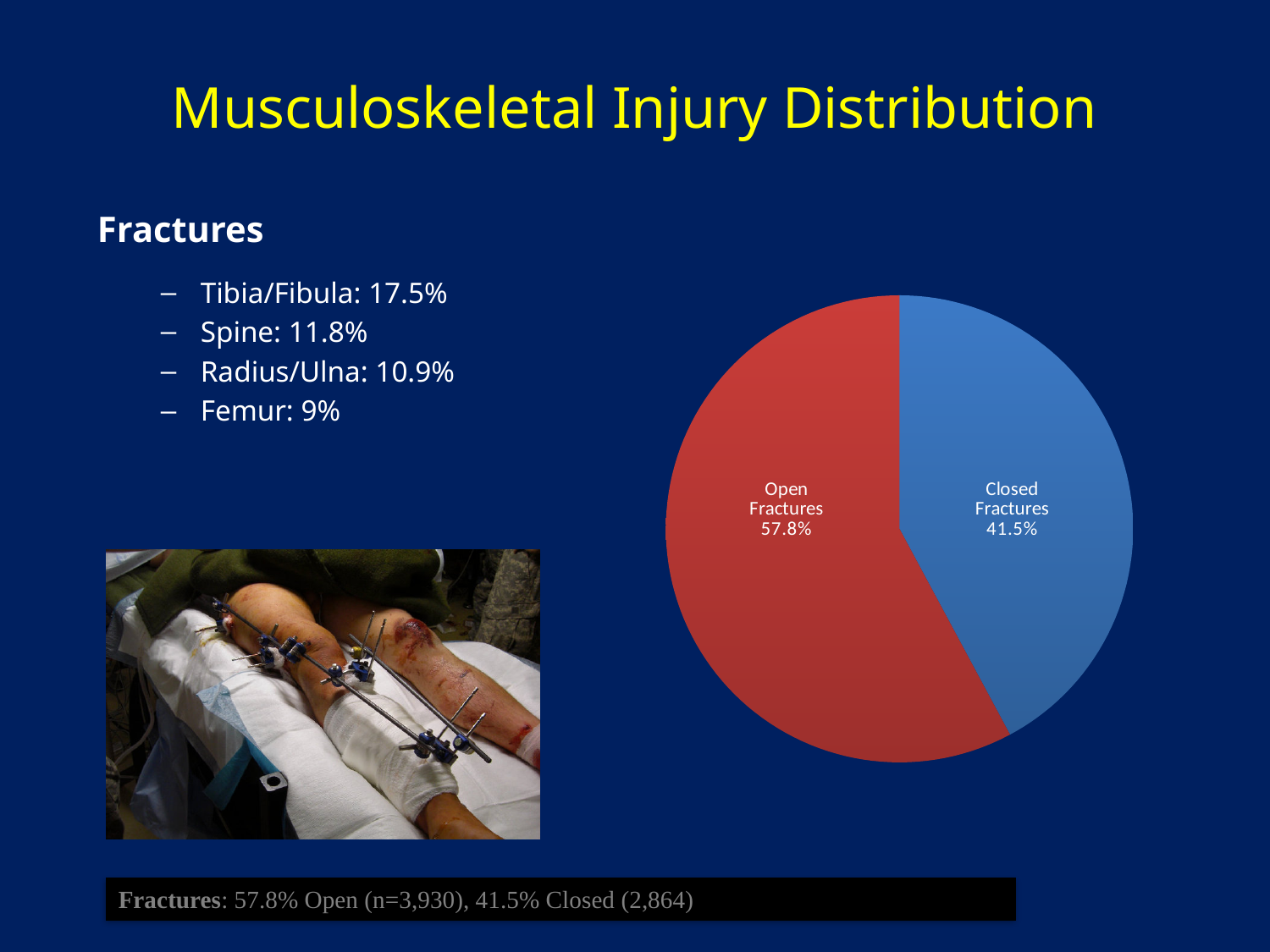
What percentage does the pie chart show for Closed Fractures? 41.5% What share of the pie does the Closed Fractures slice represent? 41.5% Which is larger in the pie chart, Open Fractures or Closed Fractures? Open Fractures How many slices does the pie chart have? 2 By how many percentage points does the Open Fractures slice exceed the Closed Fractures slice? 16.3 Which slice of the pie chart is the smallest? Closed Fractures What percentage does the pie chart show for Open Fractures? 57.8% What colour is the Closed Fractures slice in the pie chart? blue What kind of chart is shown on the slide? pie chart What colour is the Open Fractures slice in the pie chart? red Which slice of the pie chart is the largest? Open Fractures Is the value for Open Fractures greater or less than 50%? greater